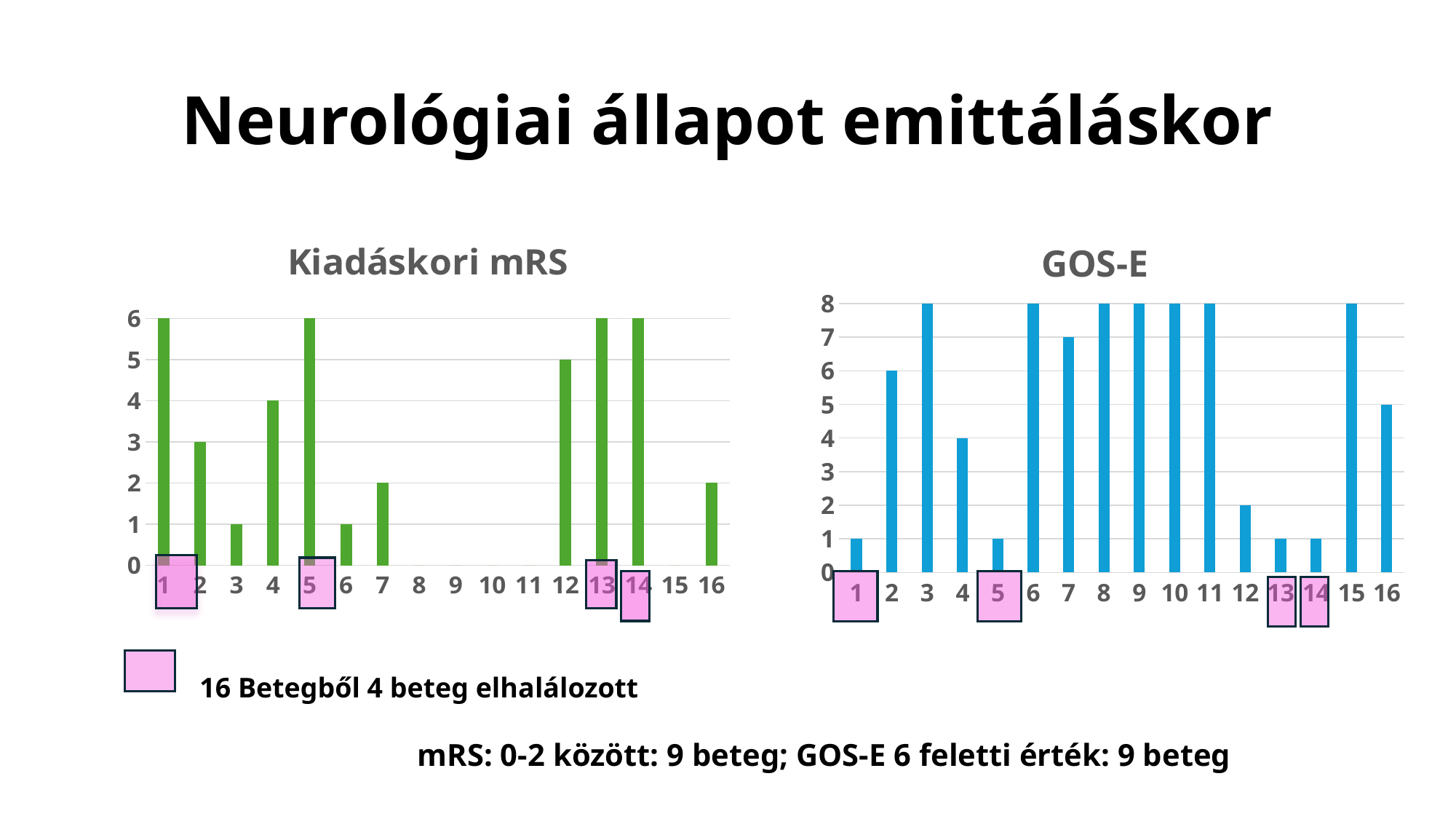
What colour are the bars in the GOS-E chart? blue In the GOS-E chart, what is the value for patient 2? 6 In the Kiadáskori mRS chart, what is the value for patient 4? 4 In the GOS-E chart, which is larger, the value for patient 12 or the value for patient 16? patient 16 How many patients are shown on the x axis of the GOS-E chart? 16 In the GOS-E chart, what is the value for patient 16? 5 In the Kiadáskori mRS chart, which is larger, the value for patient 7 or the value for patient 12? patient 12 In the GOS-E chart, what is the difference between the values for patient 3 and patient 4? 4 In the Kiadáskori mRS chart, what is the difference between the values for patient 1 and patient 2? 3 What kind of chart is the Kiadáskori mRS chart? bar chart In the Kiadáskori mRS chart, what is the value for patient 12? 5 In the GOS-E chart, what is the value for patient 7? 7